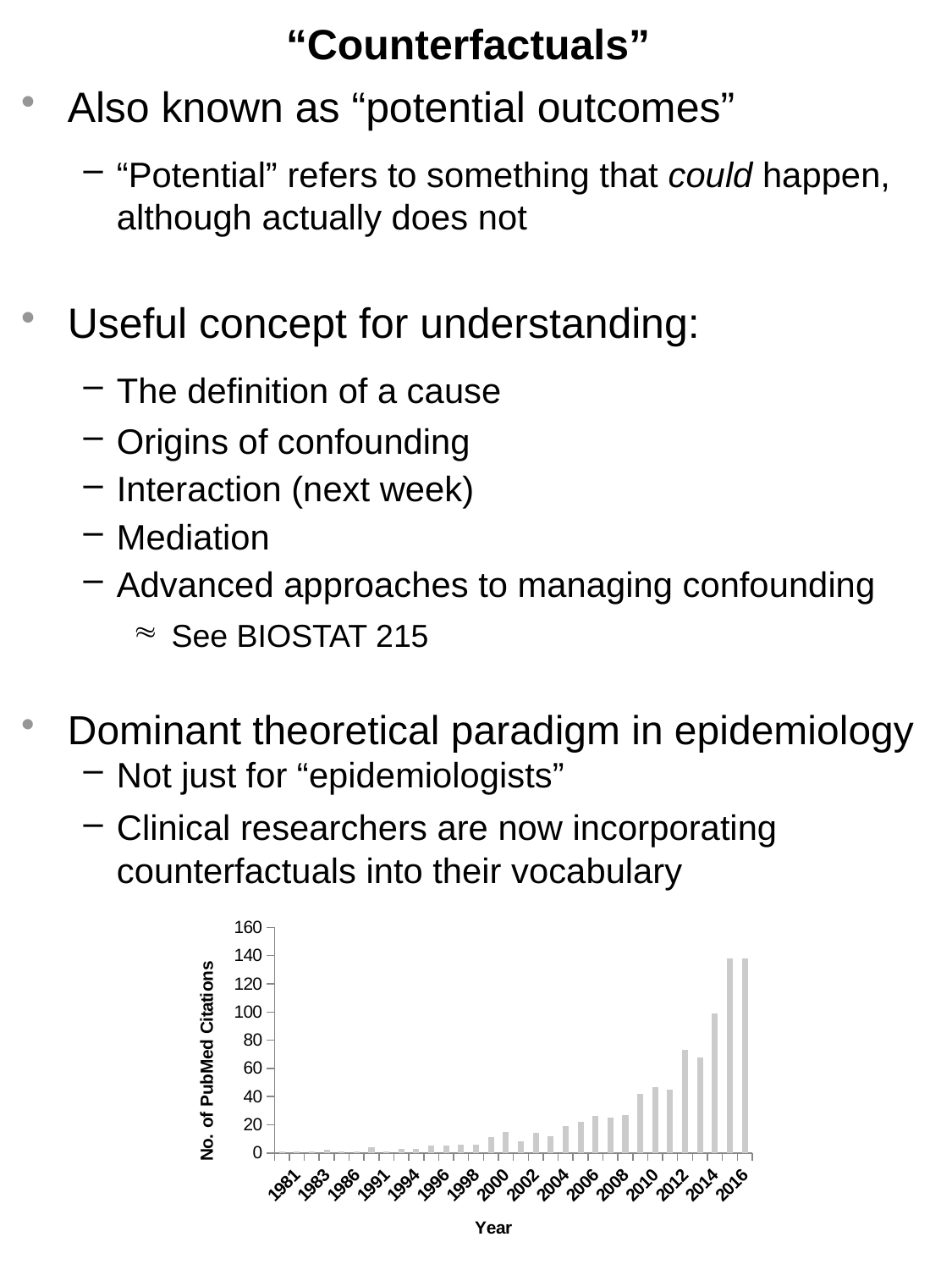
Which year has more PubMed citations, 2016 or 2010? 2016 Is the value for 2000 greater or less than 40? less Is the value for 2016 greater or less than 100? greater Which year has more PubMed citations, 1996 or 2012? 2012 What is the title of the horizontal axis of the chart? Year Is the value for 2014 greater or less than 120? less Do the number of PubMed citations generally rise or fall from 1981 to 2016? rise What kind of chart is shown at the bottom of the slide? bar chart How many year labels are shown on the horizontal axis of the chart? 16 What is the title of the vertical axis of the chart? No. of PubMed Citations